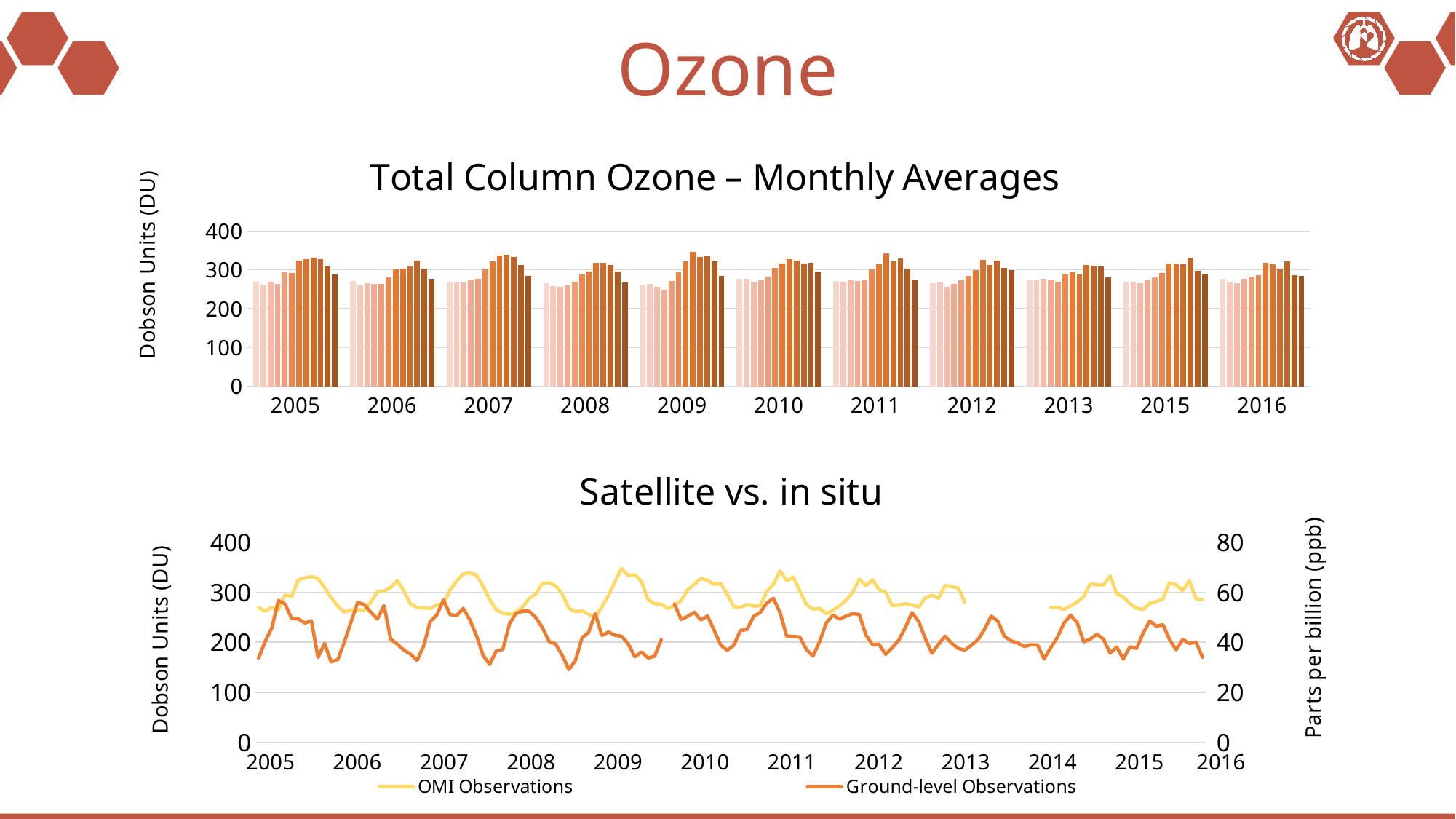
How many year groups are shown on the x axis of the 'Total Column Ozone – Monthly Averages' chart? 11 In the 'Satellite vs. in situ' chart, is the lowest point of the Ground-level Observations line greater or less than 20 ppb? greater In the 'Satellite vs. in situ' chart, is the lowest point of the OMI Observations line greater or less than 200 DU? greater In the 'Total Column Ozone – Monthly Averages' chart, are all the bars greater or less than 400? less What kind of chart is the 'Satellite vs. in situ' chart? line chart How many series does the legend of the 'Satellite vs. in situ' chart list? 2 What is the label of the right-hand y axis on the 'Satellite vs. in situ' chart? Parts per billion (ppb) Which series in the 'Satellite vs. in situ' chart is drawn in yellow? OMI Observations What kind of chart is the 'Total Column Ozone – Monthly Averages' chart? bar chart Which year is missing from the x axis of the 'Total Column Ozone – Monthly Averages' chart between 2013 and 2015? 2014